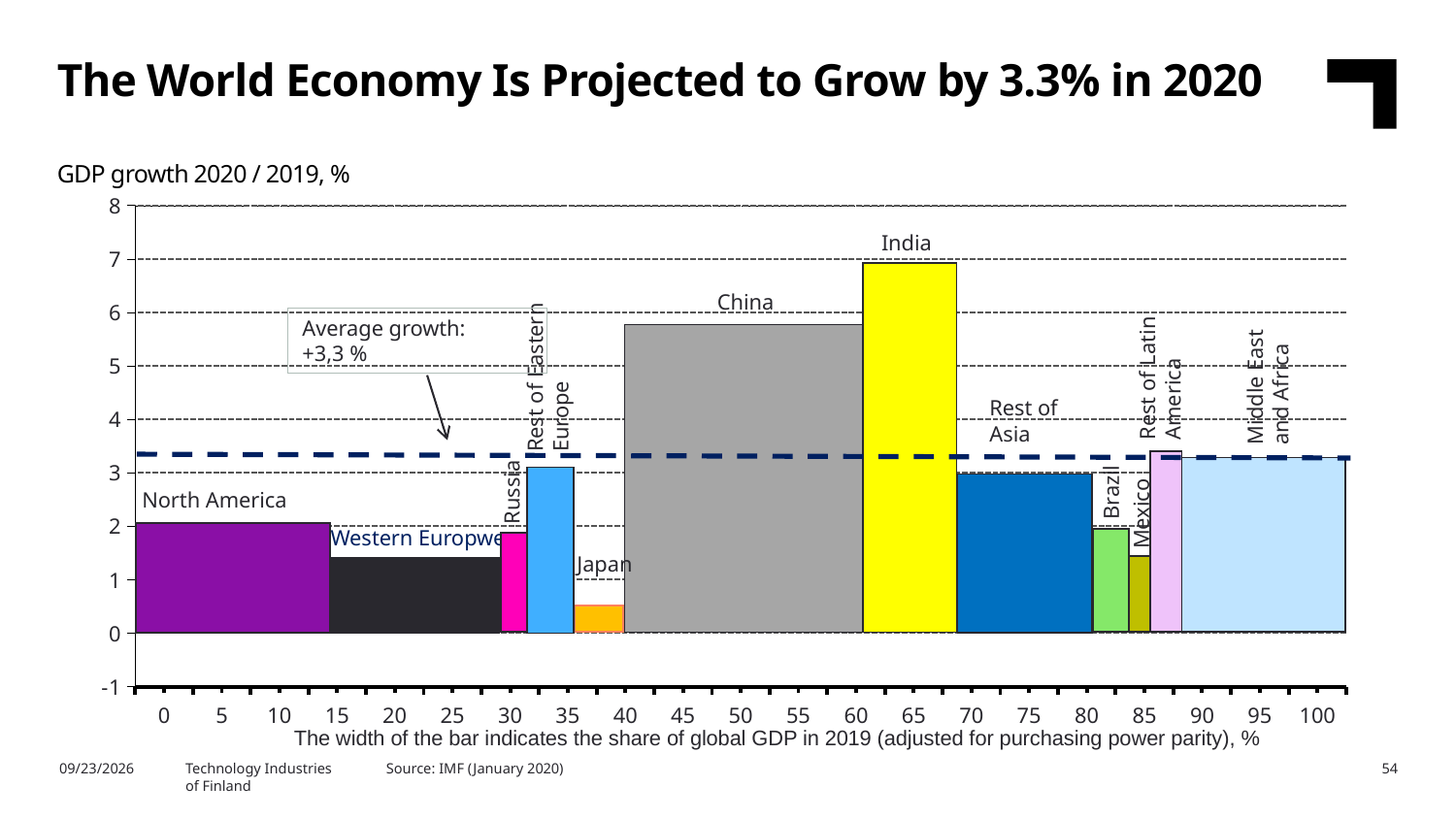
What average growth value is printed in the annotation box on the chart? +3,3 % Which has the higher projected GDP growth, North America or Western Europe? North America Which region has the highest projected GDP growth in the chart? India According to the note below the chart, what does the width of each bar indicate? The share of global GDP in 2019 (adjusted for purchasing power parity), % What type of chart is shown on the slide? bar chart Is the projected GDP growth for Western Europe greater or less than 2? less Is the projected GDP growth for China greater or less than 5? greater Which has the higher projected GDP growth, China or India? India How many regions or countries are shown as bars in the chart? 12 Which region has the lowest projected GDP growth in the chart? Japan Is the projected GDP growth for India greater or less than 6? greater